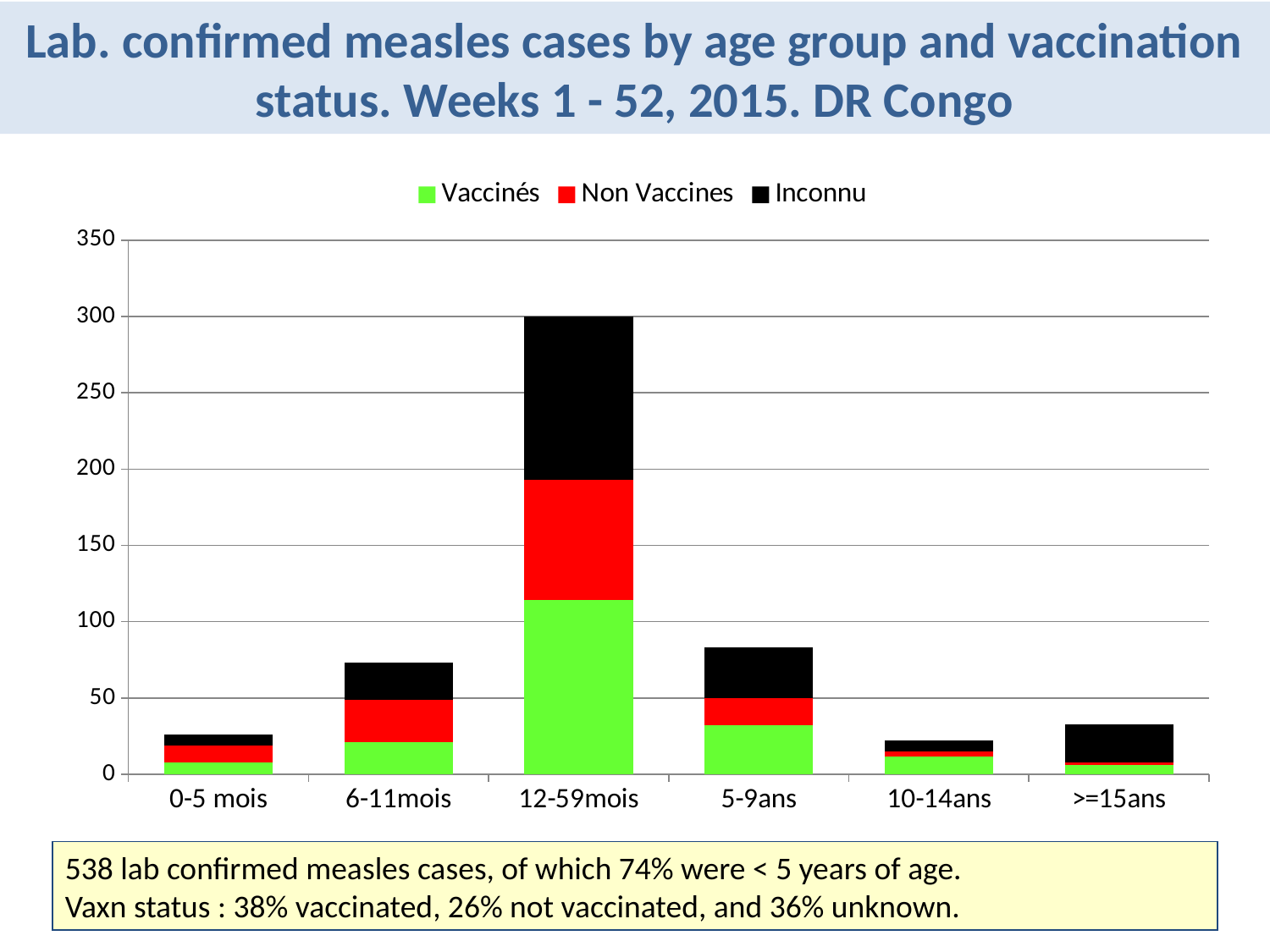
How many age group categories are shown on the x axis? 6 Which age group has the highest total number of lab confirmed measles cases? 12-59mois Is the Vaccinés value for 12-59mois greater or less than 100? greater How many series does the legend list? 3 Is the total number of cases for 12-59mois greater or less than 250? greater What kind of chart is shown on the slide? stacked bar chart Which colour represents the Inconnu series in the chart? black Is the total number of cases for 0-5 mois greater or less than 50? less Which has more total cases, 12-59mois or 5-9ans? 12-59mois Which has more total cases, 6-11mois or 0-5 mois? 6-11mois